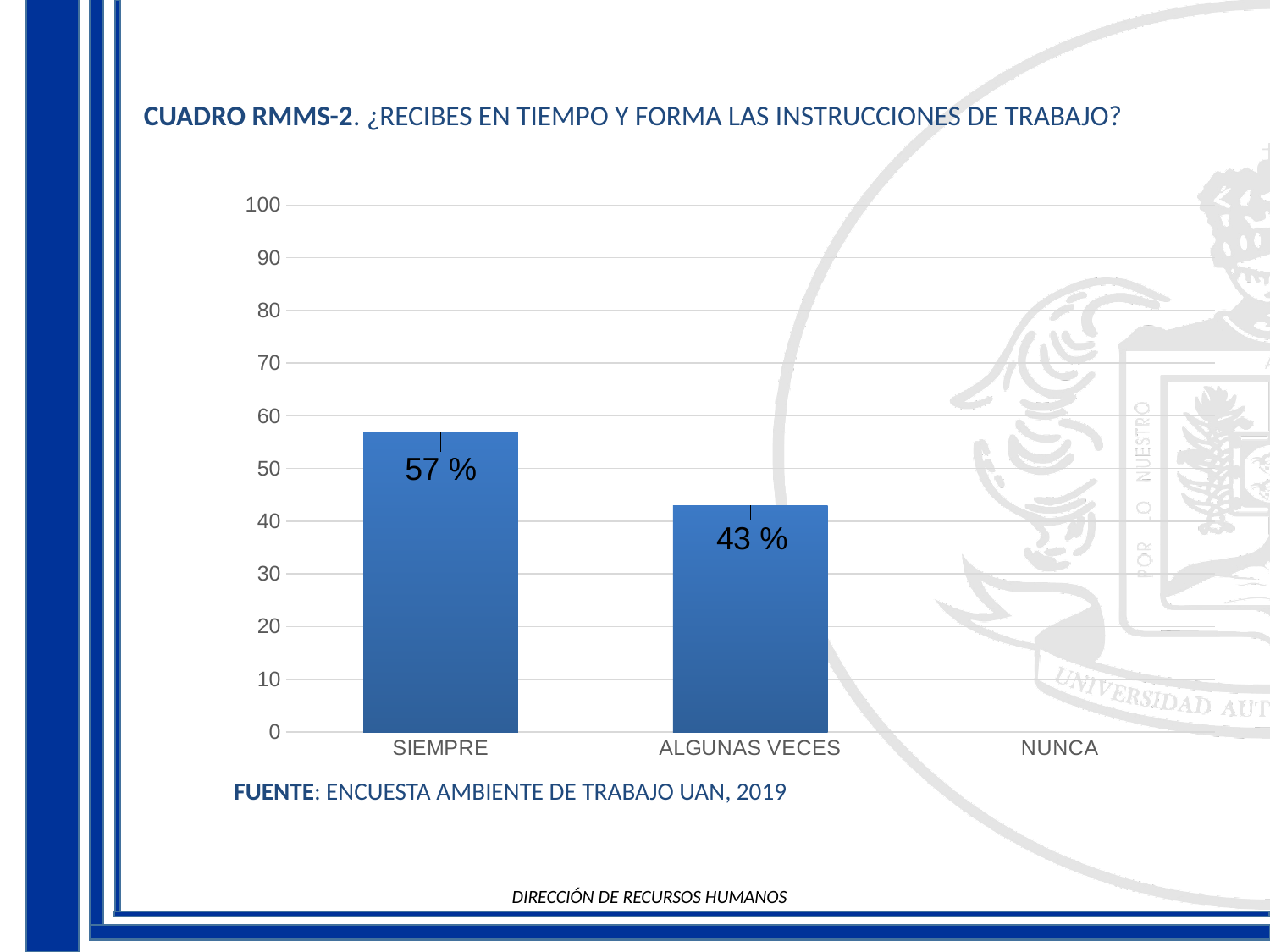
How many categories are shown on the x axis? 3 What is the value for SIEMPRE? 57 % What is the highest value shown on the vertical axis? 100 Which category has the highest value? SIEMPRE What is the value for ALGUNAS VECES? 43 % Which is larger, the value for SIEMPRE or the value for ALGUNAS VECES? SIEMPRE Do the bar values rise or fall from SIEMPRE to ALGUNAS VECES? fall What source is cited below the chart? ENCUESTA AMBIENTE DE TRABAJO UAN, 2019 What kind of chart is shown on the slide? bar chart Is the value for SIEMPRE greater or less than 50? greater Is the value for ALGUNAS VECES greater or less than 50? less What is the difference between the values for SIEMPRE and ALGUNAS VECES? 14 %